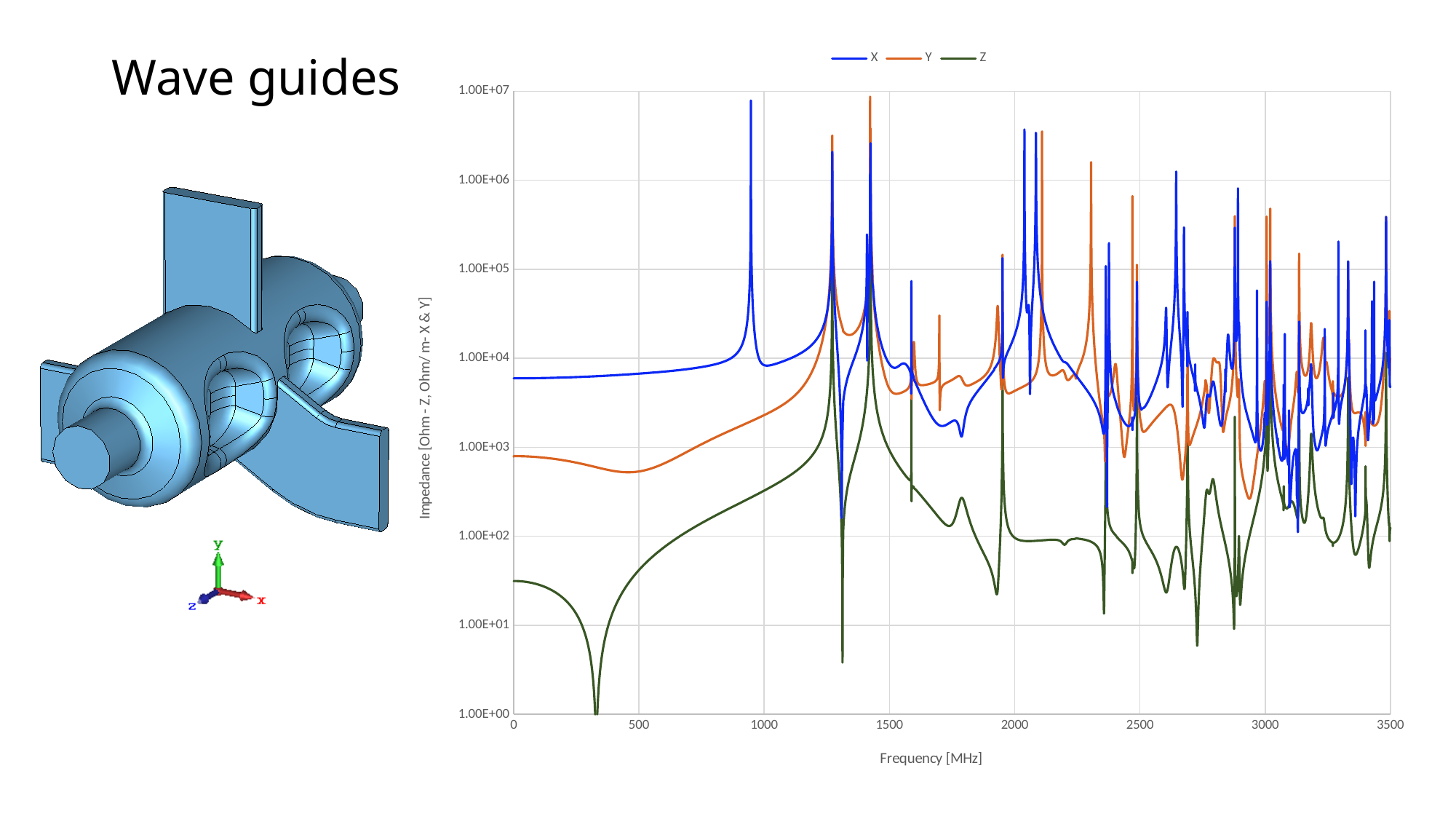
Which series reaches the lowest impedance value anywhere on the chart? Z How many series does the legend list? 3 What is the title of the x axis of the chart? Frequency [MHz] Does the X series rise or fall from 0 MHz to 900 MHz? rise Does the Z series rise or fall from 0 MHz to 300 MHz? fall What colour is the Z series drawn in? green Is the value for Y at 500 MHz greater or less than 1.00E+03? less What kind of chart is shown on the slide? line chart Is the value for X at 0 MHz greater or less than 1.00E+03? greater At 0 MHz, which series has the higher impedance, X or Y? X At 500 MHz, which series has the lower impedance, Y or Z? Z Is the value for Z at 0 MHz greater or less than 1.00E+02? less